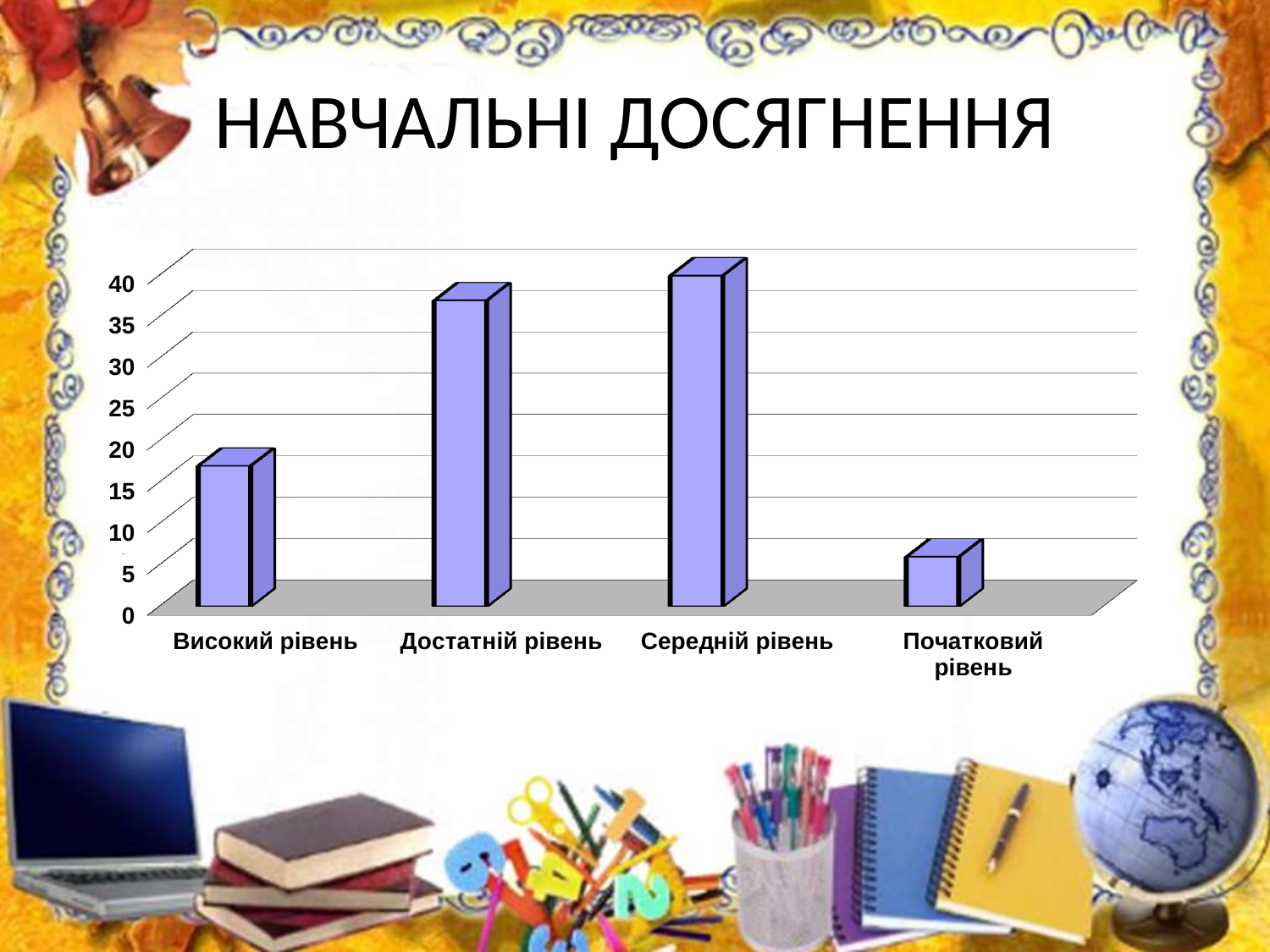
Is the value for Високий рівень greater or less than 20? less How many categories are shown on the x axis of the chart? 4 Is the value for Високий рівень greater or less than 10? greater What is the title of the slide containing the chart? НАВЧАЛЬНІ ДОСЯГНЕННЯ Is the value for Достатній рівень greater or less than 30? greater Which category has the lowest bar? Початковий рівень Which category has the highest bar? Середній рівень Which is larger, the value for Високий рівень or the value for Початковий рівень? Високий рівень Which is larger, the value for Достатній рівень or the value for Високий рівень? Достатній рівень What kind of chart is shown on the slide? bar chart